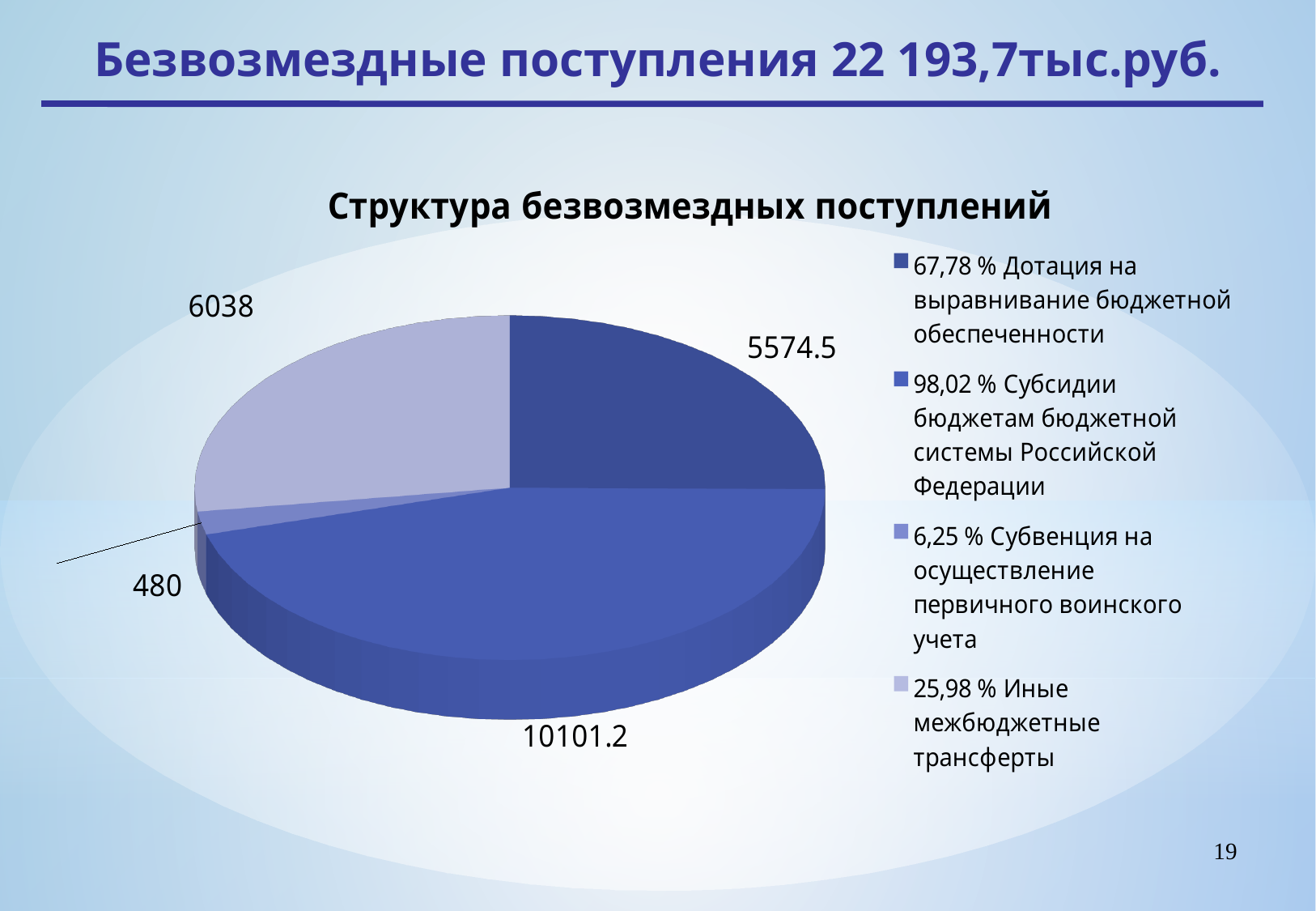
What is the title of the chart? Структура безвозмездных поступлений Which is larger: the slice for Иные межбюджетные трансферты or the slice for Дотация на выравнивание бюджетной обеспеченности? Иные межбюджетные трансферты What is the value of the slice for Иные межбюджетные трансферты? 6038 What is the value of the slice for Субсидии бюджетам бюджетной системы Российской Федерации? 10101.2 Which category has the smallest slice in the pie chart? Субвенция на осуществление первичного воинского учета What is the value of the slice for Дотация на выравнивание бюджетной обеспеченности? 5574.5 What kind of chart is shown on the slide? pie chart Which category has the largest slice in the pie chart? Субсидии бюджетам бюджетной системы Российской Федерации How many slices does the pie chart have? 4 What is the value of the slice for Субвенция на осуществление первичного воинского учета? 480 What is the difference between the values for Субсидии бюджетам бюджетной системы Российской Федерации and Дотация на выравнивание бюджетной обеспеченности? 4526.7 What is the total of all four slice values shown on the pie chart? 22193.7